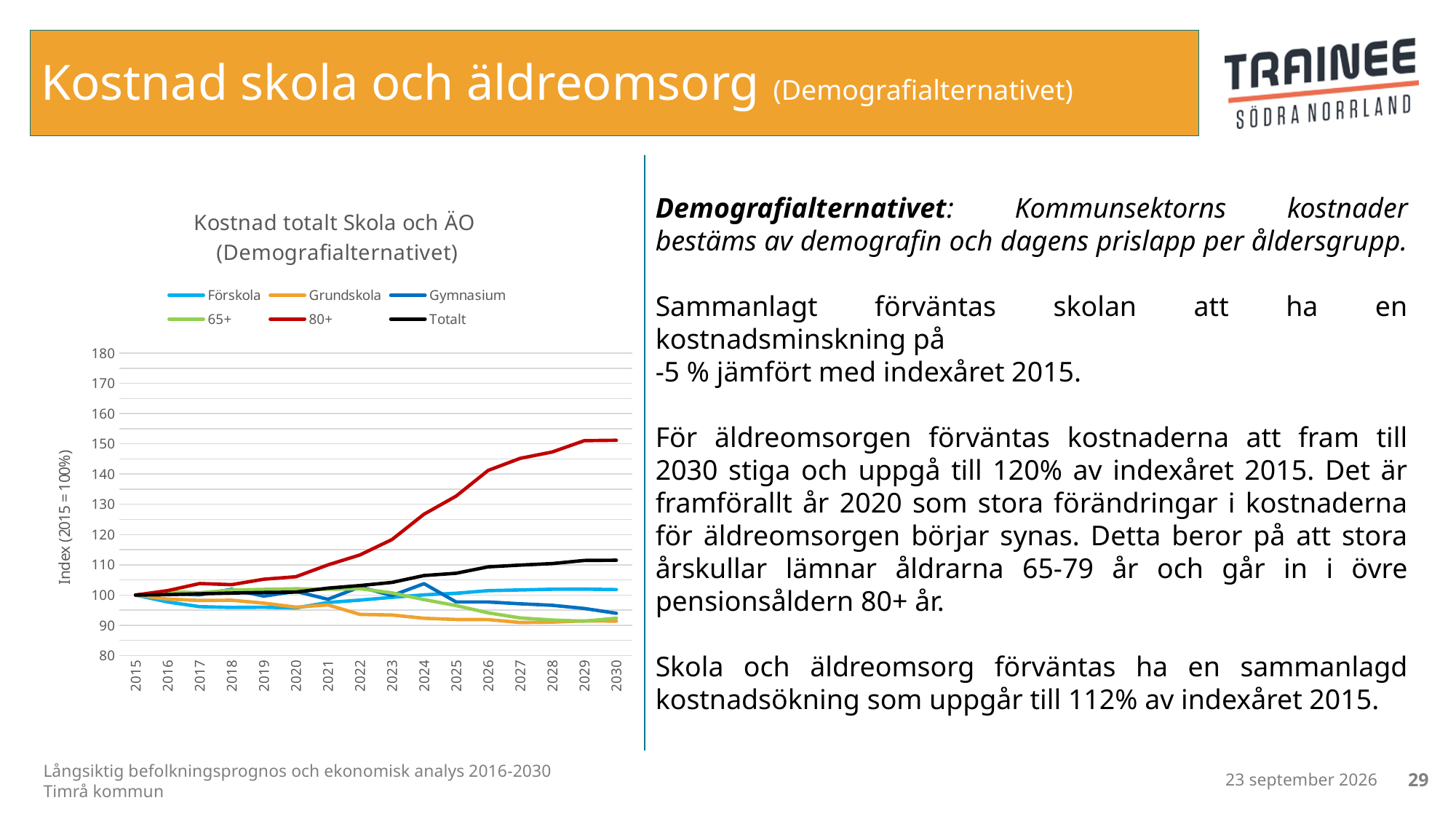
What is the label of the y axis of the chart? Index (2015 = 100%) Does the 80+ series rise or fall from 2015 to 2030? rise Is the value for Grundskola in 2030 greater or less than 100? less What is the index value of the Totalt series in 2015? 100 In 2030, which is larger: Förskola or Grundskola? Förskola How many years are shown along the x axis of the chart? 16 Which series has the lowest value in 2024? Grundskola Which series has the highest value in 2030? 80+ Is the value for 80+ in 2030 greater or less than 140? greater How many series does the legend of the chart list? 6 Is the value for Totalt in 2030 greater or less than 120? less What kind of chart is shown on the slide? line chart